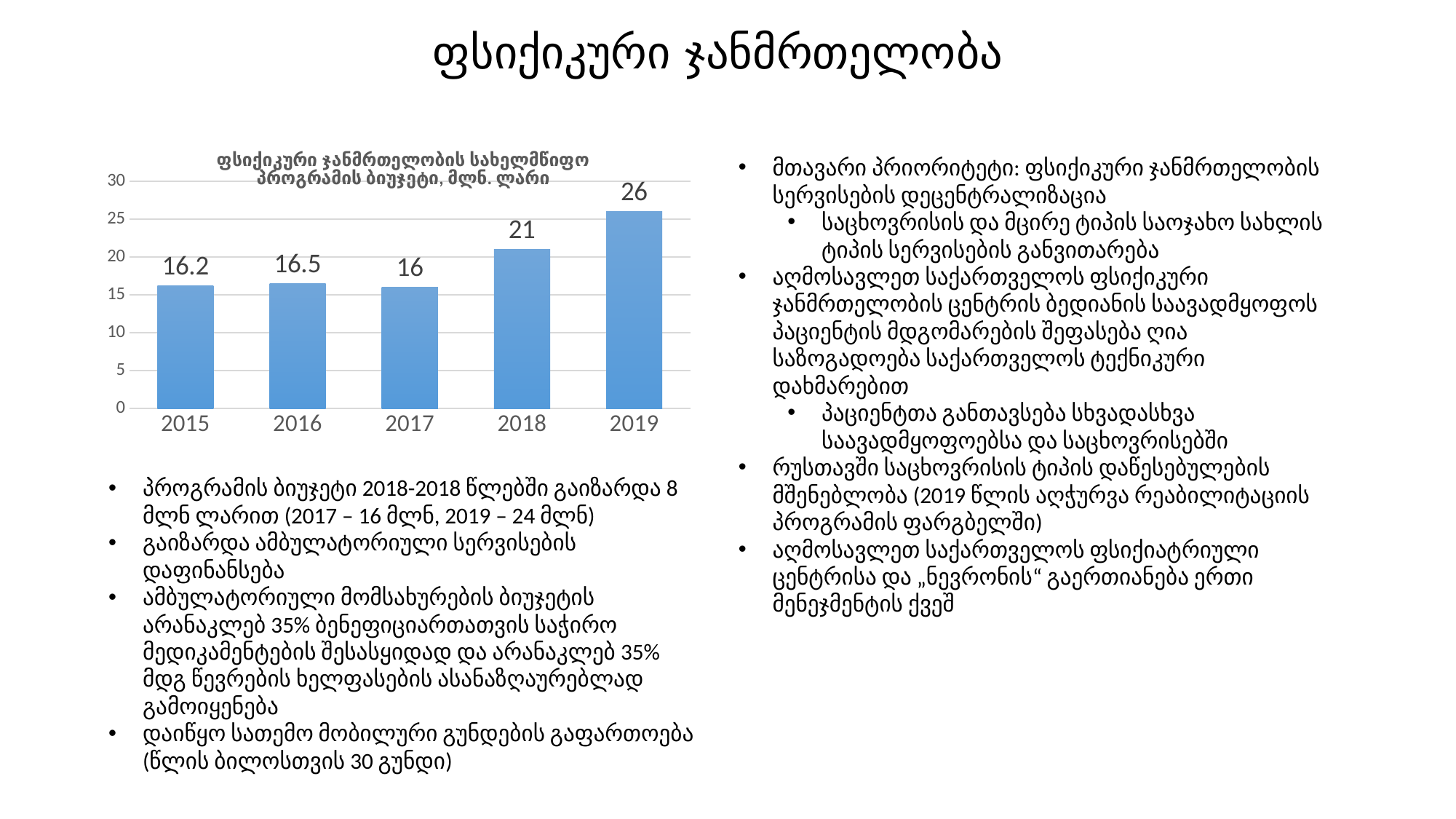
What is the value for 2015 in the chart? 16.2 What is the difference between the values for 2016 and 2015? 0.3 What is the value for 2018 in the chart? 21 Do the values rise or fall from 2017 to 2019? rise Which is larger, the value for 2018 or the value for 2017? 2018 What is the value for 2019 in the chart? 26 How many years are shown on the x axis of the chart? 5 Is the value for 2019 greater or less than 25? greater What is the difference between the values for 2019 and 2018? 5 What kind of chart is shown on the slide? bar chart Which year has the lowest value in the chart? 2017 Which year has the highest value in the chart? 2019